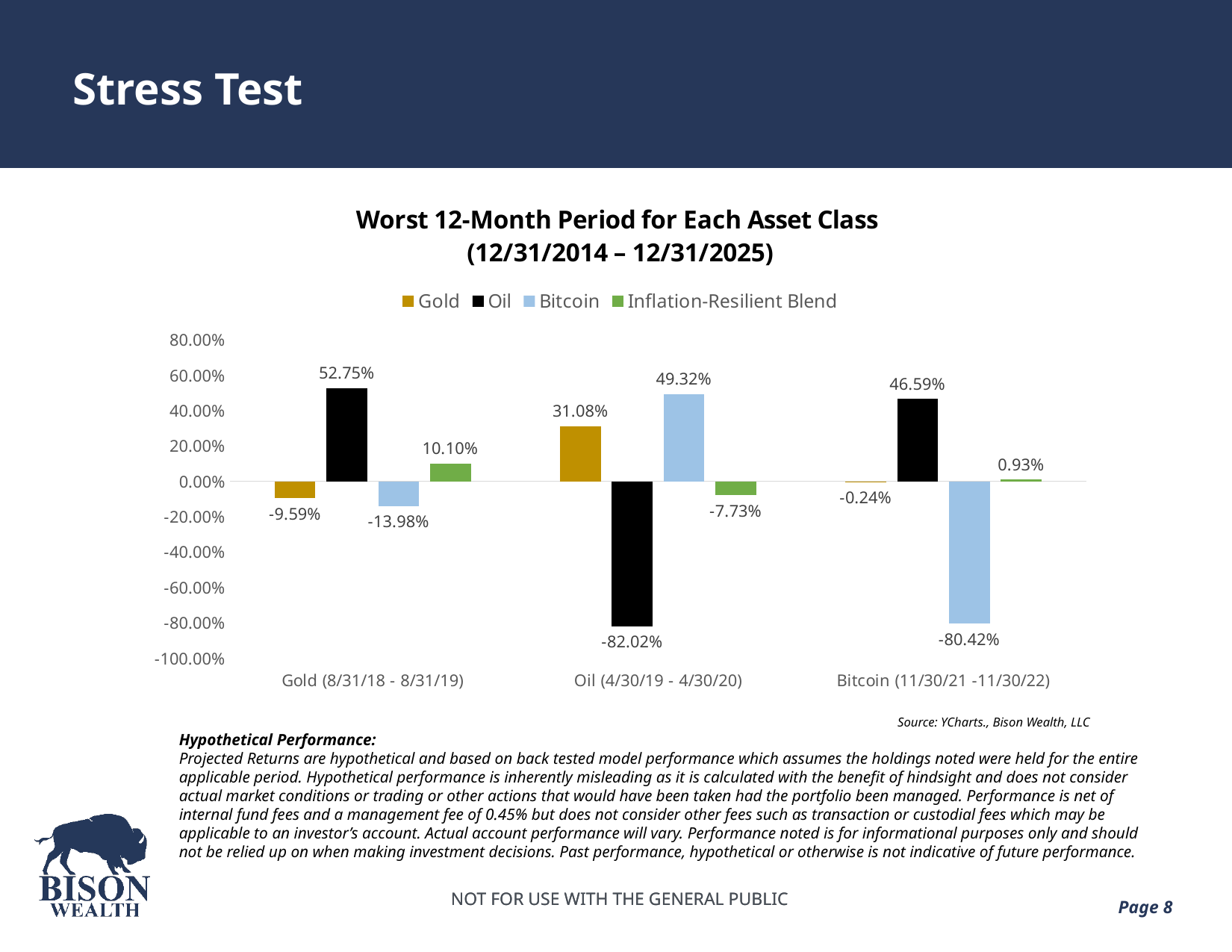
How many series does the legend list? 4 Which series has the lowest value in the Oil (4/30/19 - 4/30/20) period? Oil What kind of chart is shown on the slide? Bar chart How many periods (categories) are shown on the x axis? 3 What is the title of the chart? Worst 12-Month Period for Each Asset Class (12/31/2014 – 12/31/2025) What is the value for Oil in the Gold (8/31/18 - 8/31/19) period? 52.75% Which is larger in the Gold (8/31/18 - 8/31/19) period: the Inflation-Resilient Blend value or the Gold value? Inflation-Resilient Blend What is the value for the Inflation-Resilient Blend in the Oil (4/30/19 - 4/30/20) period? -7.73% What is the value for Gold in the Bitcoin (11/30/21 - 11/30/22) period? -0.24% What is the difference between the Bitcoin value and the Gold value in the Oil (4/30/19 - 4/30/20) period? 18.24% What is the value for Bitcoin in the Bitcoin (11/30/21 - 11/30/22) period? -80.42% Which series has the highest value in the Bitcoin (11/30/21 - 11/30/22) period? Oil